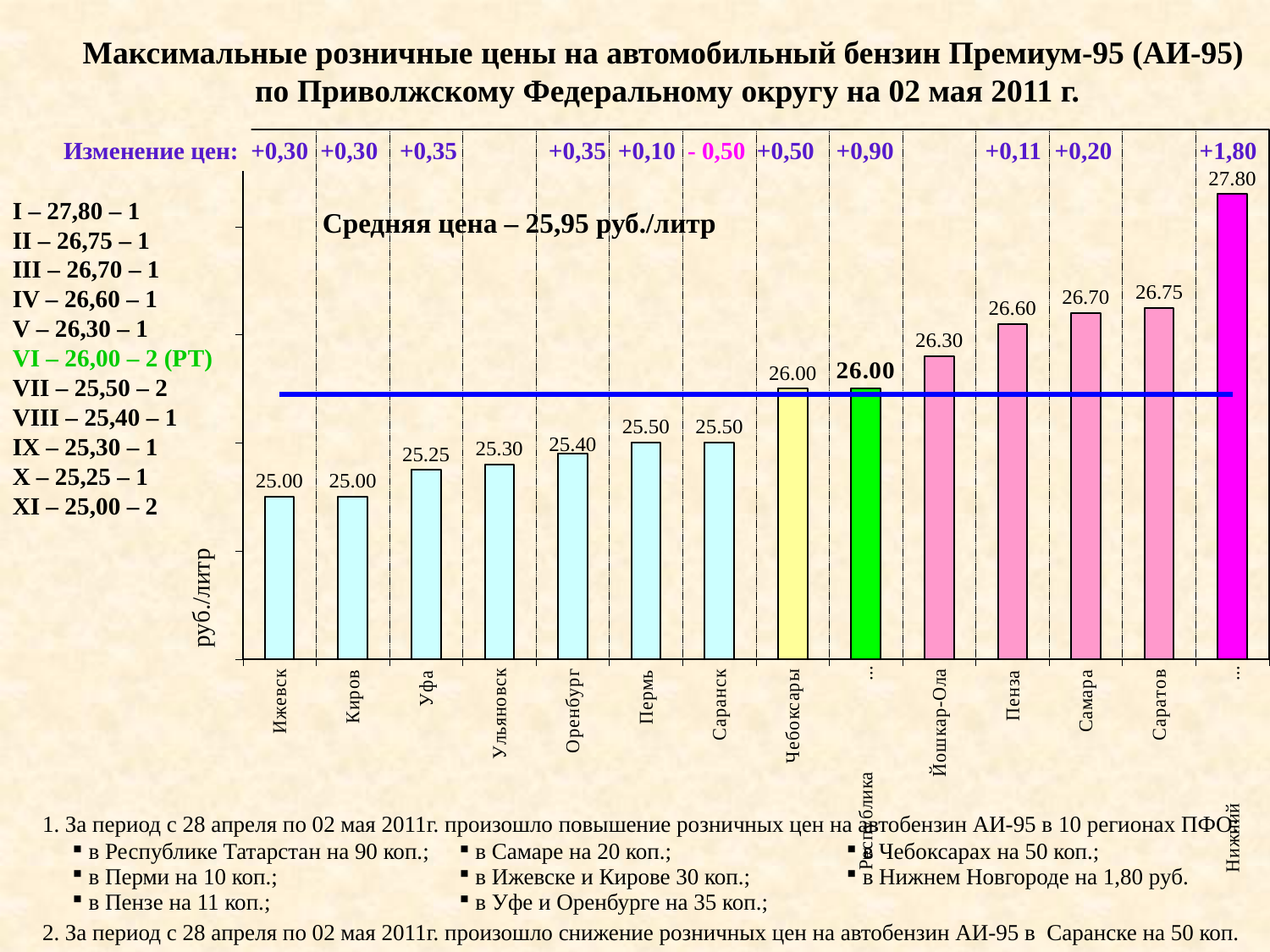
Which is larger, the value for Пермь or the value for Ульяновск? Пермь What is the maximum retail price shown for Уфа? 25.25 How many bars (regions) are plotted on the chart? 14 What is the value of the bar for Йошкар-Ола? 26.30 What average price is stated on the chart? 25,95 руб./литр What kind of chart is shown on the slide? bar chart What is the lowest value shown on the chart? 25.00 What is the highest value shown on the chart? 27.80 Which region has the highest bar on the chart? Нижний Новгород What is the value of the bar for Саратов? 26.75 What is the value of the bar for Оренбург? 25.40 What is the difference between the values for Самара and Пенза? 0.10